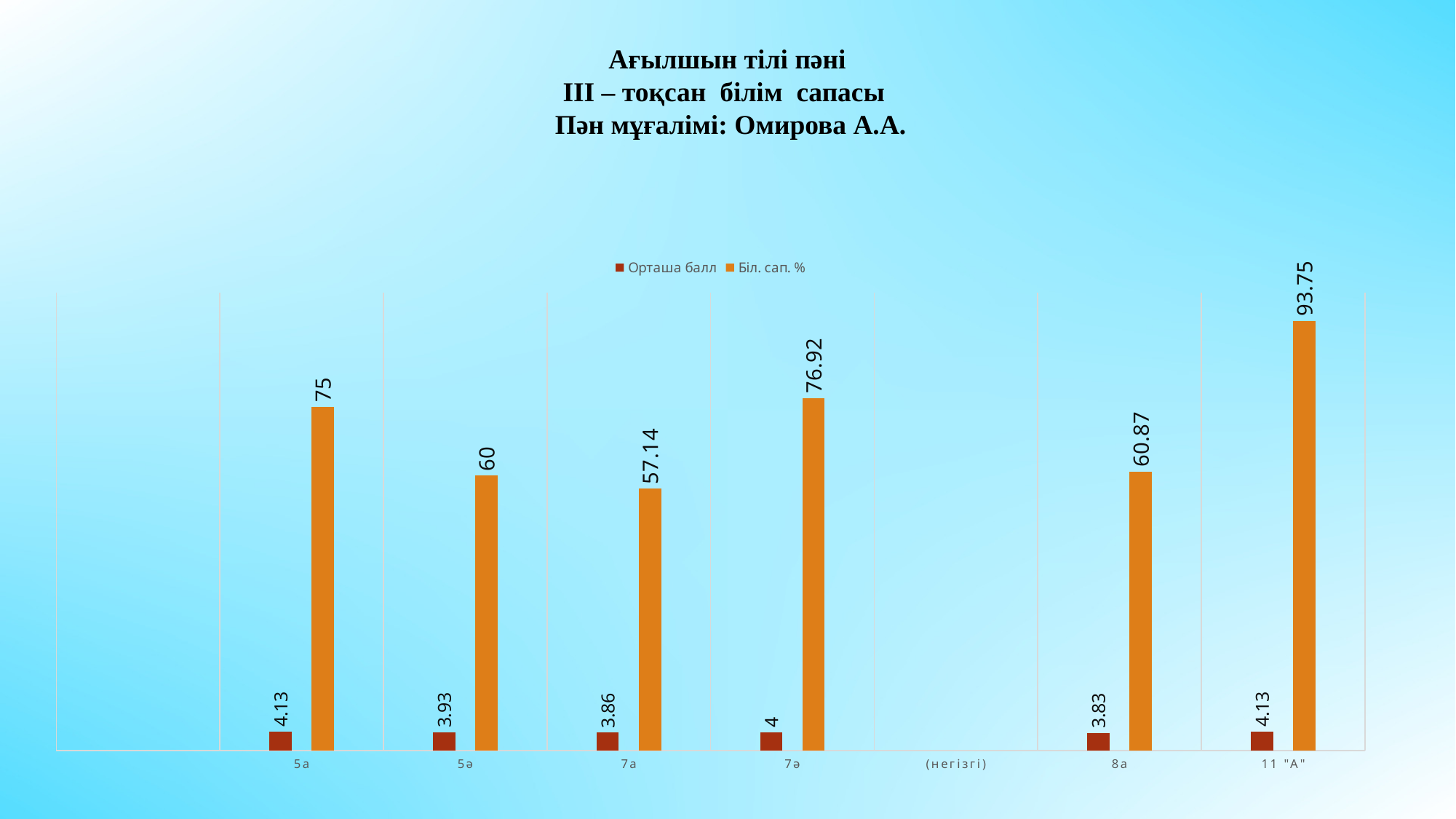
Which category has the highest Біл. сап. % value? 11 "А" Which category has the lowest Біл. сап. % value? 7а How many series does the legend list? 2 What is the Орташа балл value for 5ә? 3.93 What colour are the Біл. сап. % bars? Orange Which has a higher Біл. сап. % value, 7ә or 8а? 7ә What is the difference between the Біл. сап. % values for 11 "А" and 5а? 18.75 Which category has the lowest Орташа балл value? 8а What is the Біл. сап. % value for 11 "А"? 93.75 What kind of chart is shown on the slide? Bar chart What is the Біл. сап. % value for 7а? 57.14 What is the Орташа балл value for 7ә? 4